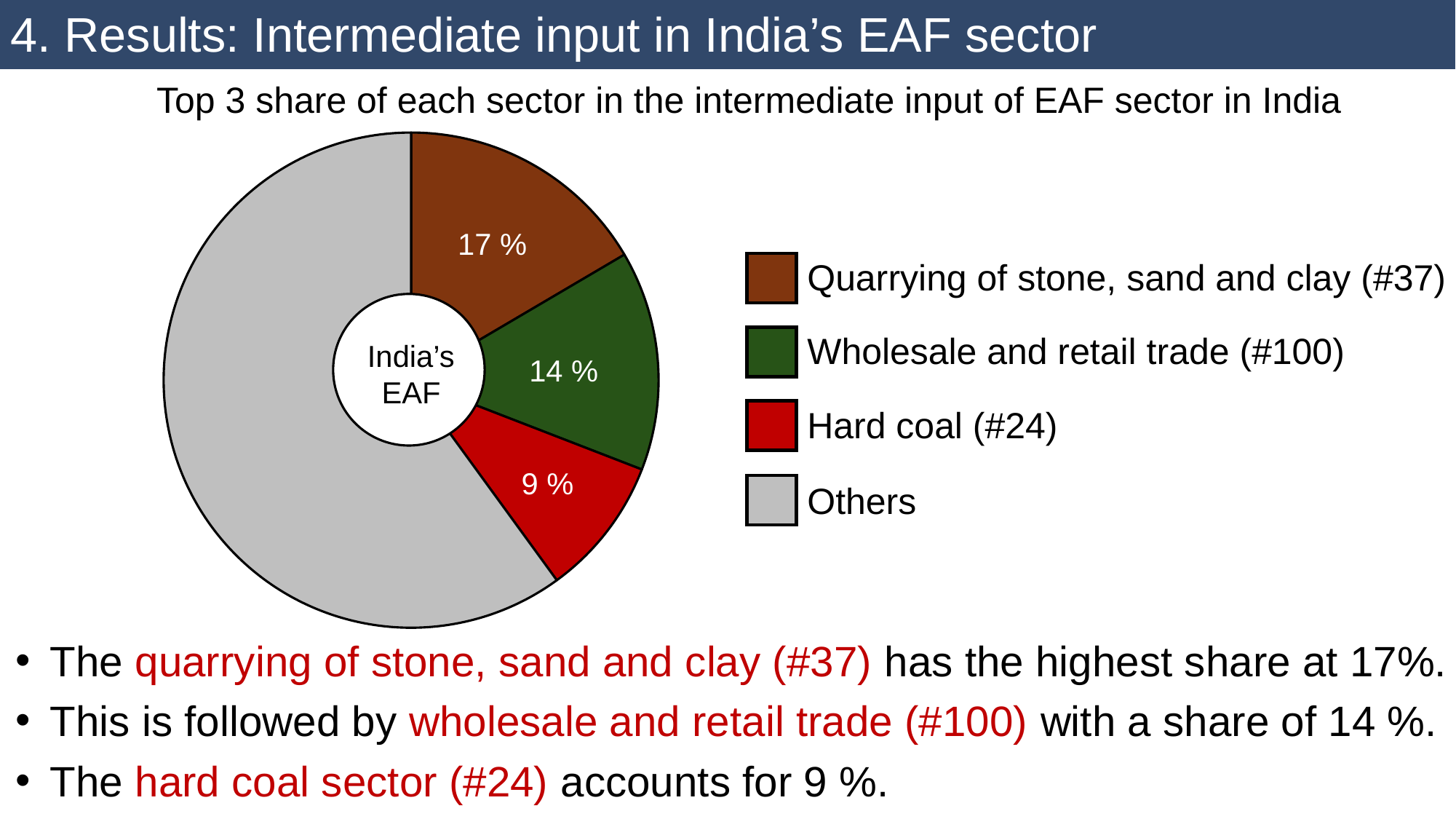
What is the combined share of the three named sectors (Quarrying, Wholesale and retail trade, Hard coal)? 40 % Which has a larger share, Wholesale and retail trade (#100) or Hard coal (#24)? Wholesale and retail trade (#100) What is the difference in share between Quarrying of stone, sand and clay (#37) and Hard coal (#24)? 8 % What is the share of Quarrying of stone, sand and clay (#37) in the intermediate input of India's EAF sector? 17 % Among the three named sectors, which has the lowest share? Hard coal (#24) What text is written in the centre of the pie chart? India's EAF What is the difference in share between Quarrying of stone, sand and clay (#37) and Wholesale and retail trade (#100)? 3 % What is the share of Wholesale and retail trade (#100) in the chart? 14 % What is the share of Hard coal (#24) in the chart? 9 % How many entries does the legend list? 4 What kind of chart is shown on the slide? Pie chart Among the three named sectors, which has the highest share? Quarrying of stone, sand and clay (#37)